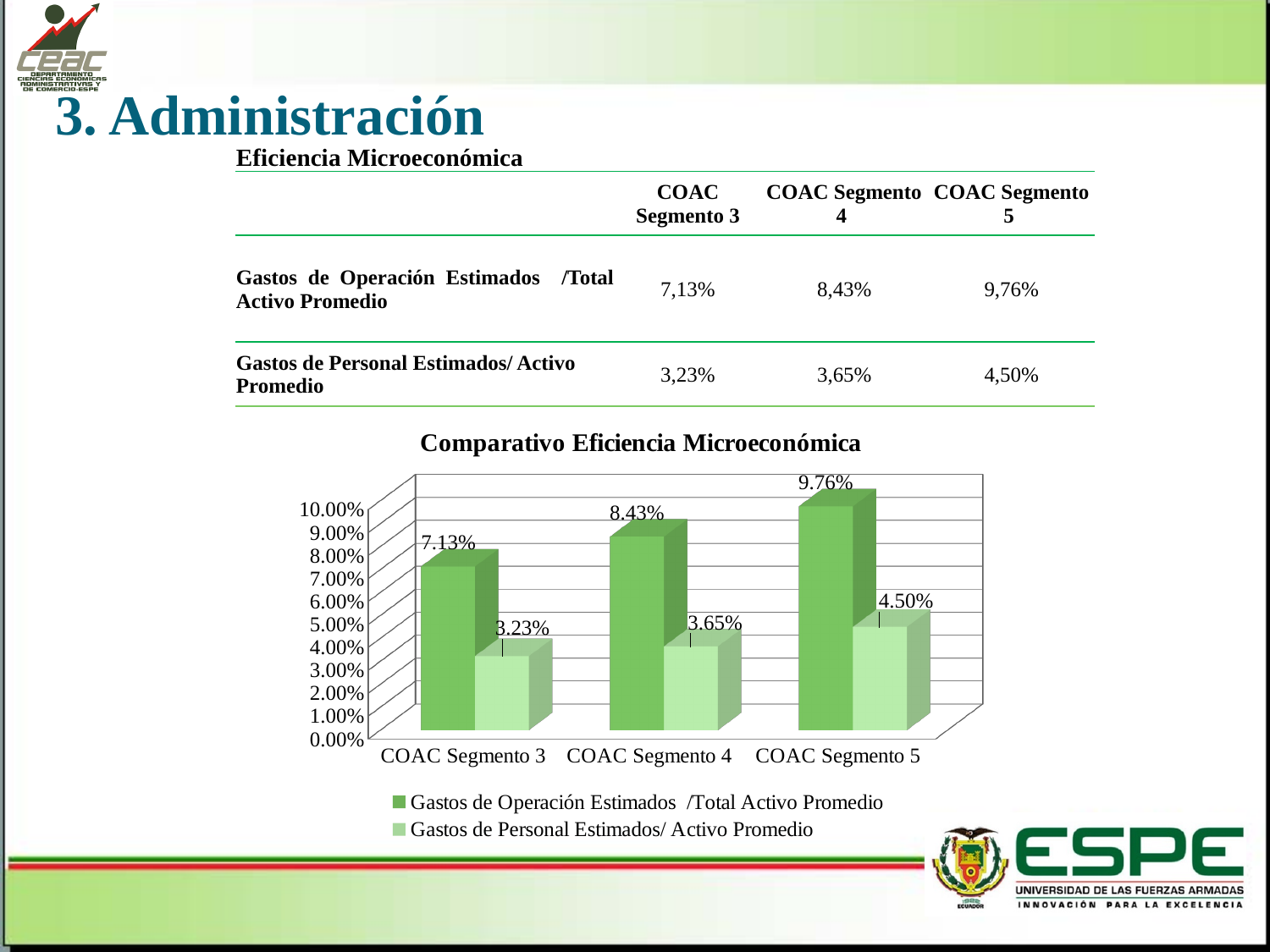
What is the value of Gastos de Operación Estimados /Total Activo Promedio for COAC Segmento 5 in the chart? 9.76% What is the value of Gastos de Operación Estimados /Total Activo Promedio for COAC Segmento 3? 7.13% Which is larger: Gastos de Operación Estimados /Total Activo Promedio for COAC Segmento 4 or for COAC Segmento 5? COAC Segmento 5 How many categories are shown on the x axis of the chart? 3 Which category has the lowest value for Gastos de Personal Estimados/ Activo Promedio? COAC Segmento 3 Which category has the highest value for Gastos de Operación Estimados /Total Activo Promedio? COAC Segmento 5 What is the difference between the Gastos de Personal Estimados/ Activo Promedio values for COAC Segmento 5 and COAC Segmento 3? 1.27 percentage points What is the difference between the Gastos de Operación Estimados /Total Activo Promedio values for COAC Segmento 5 and COAC Segmento 3? 2.63 percentage points Do the Gastos de Operación Estimados /Total Activo Promedio values rise or fall from COAC Segmento 3 to COAC Segmento 5? Rise What kind of chart is shown on the slide? Bar chart What is the value of Gastos de Personal Estimados/ Activo Promedio for COAC Segmento 4 in the chart? 3.65% How many series does the chart legend list? 2